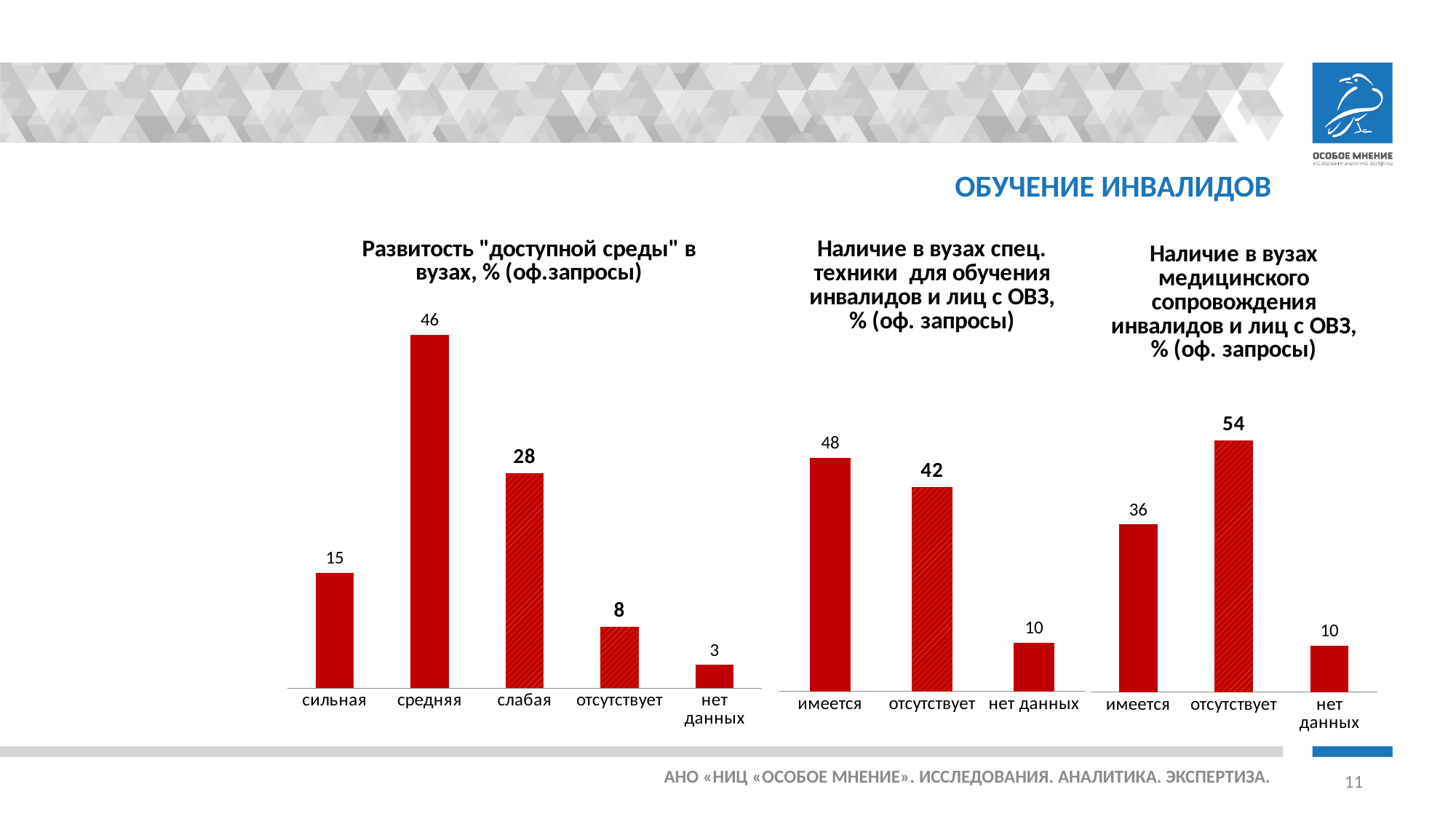
In the right chart 'Наличие в вузах медицинского сопровождения инвалидов и лиц с ОВЗ', what is the value for 'отсутствует'? 54 How many charts are shown on the slide? 3 In the right chart 'Наличие в вузах медицинского сопровождения инвалидов и лиц с ОВЗ', which category has the highest value? отсутствует In the left chart 'Развитость "доступной среды" в вузах', what is the difference between 'средняя' and 'слабая'? 18 How many categories are shown in the left chart 'Развитость "доступной среды" в вузах'? 5 In the left chart 'Развитость "доступной среды" в вузах', which category has the lowest value? нет данных In the right chart 'Наличие в вузах медицинского сопровождения инвалидов и лиц с ОВЗ', what is the value for 'нет данных'? 10 In the middle chart 'Наличие в вузах спец. техники для обучения инвалидов и лиц с ОВЗ', what is the difference between 'имеется' and 'отсутствует'? 6 In the middle chart 'Наличие в вузах спец. техники для обучения инвалидов и лиц с ОВЗ', what is the value for 'имеется'? 48 What kind of chart is the left chart 'Развитость "доступной среды" в вузах'? bar chart In the left chart 'Развитость "доступной среды" в вузах, % (оф.запросы)', what is the value for 'средняя'? 46 In the middle chart 'Наличие в вузах спец. техники для обучения инвалидов и лиц с ОВЗ', which is larger: 'имеется' or 'отсутствует'? имеется